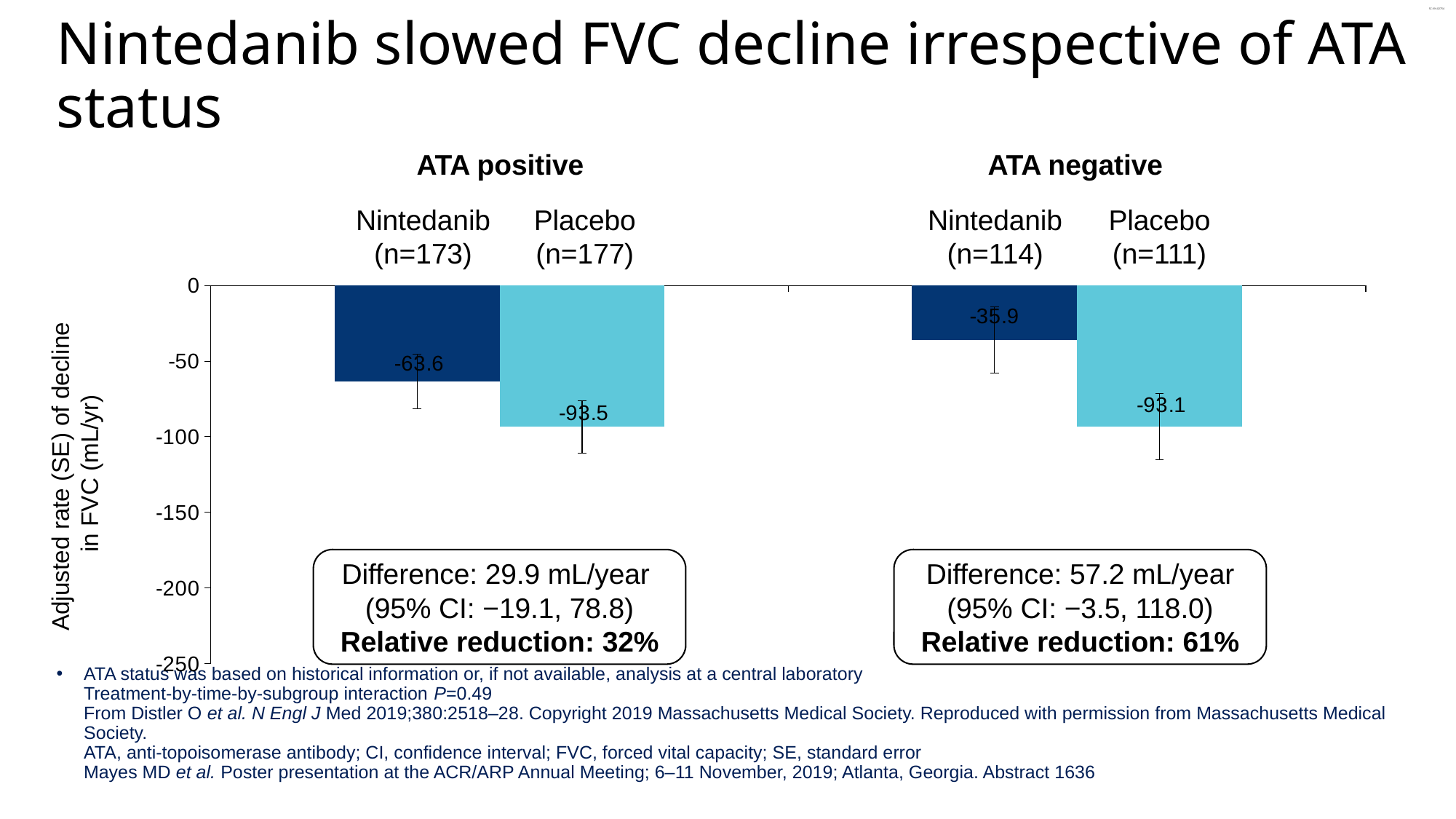
What is the adjusted rate of FVC decline for Placebo in the ATA negative group? -93.1 Is the value for Placebo in the ATA positive group greater or less than -50? less Which shows a larger decline in FVC: Nintedanib in the ATA positive group or Nintedanib in the ATA negative group? Nintedanib in the ATA positive group Which bar shows the smallest decline in FVC (the value closest to zero)? Nintedanib, ATA negative How many bars are plotted in the chart? 4 What is the adjusted rate of FVC decline for Nintedanib in the ATA positive group? -63.6 What is the difference between the Nintedanib and Placebo rates of decline in the ATA negative group, as stated on the slide? 57.2 mL/year What is the adjusted rate of FVC decline for Placebo in the ATA positive group? -93.5 What is the difference between the Nintedanib and Placebo rates of decline in the ATA positive group, as stated on the slide? 29.9 mL/year What is the label of the vertical axis? Adjusted rate (SE) of decline in FVC (mL/yr) What kind of chart is shown on the slide? bar chart What is the adjusted rate of FVC decline for Nintedanib in the ATA negative group? -35.9